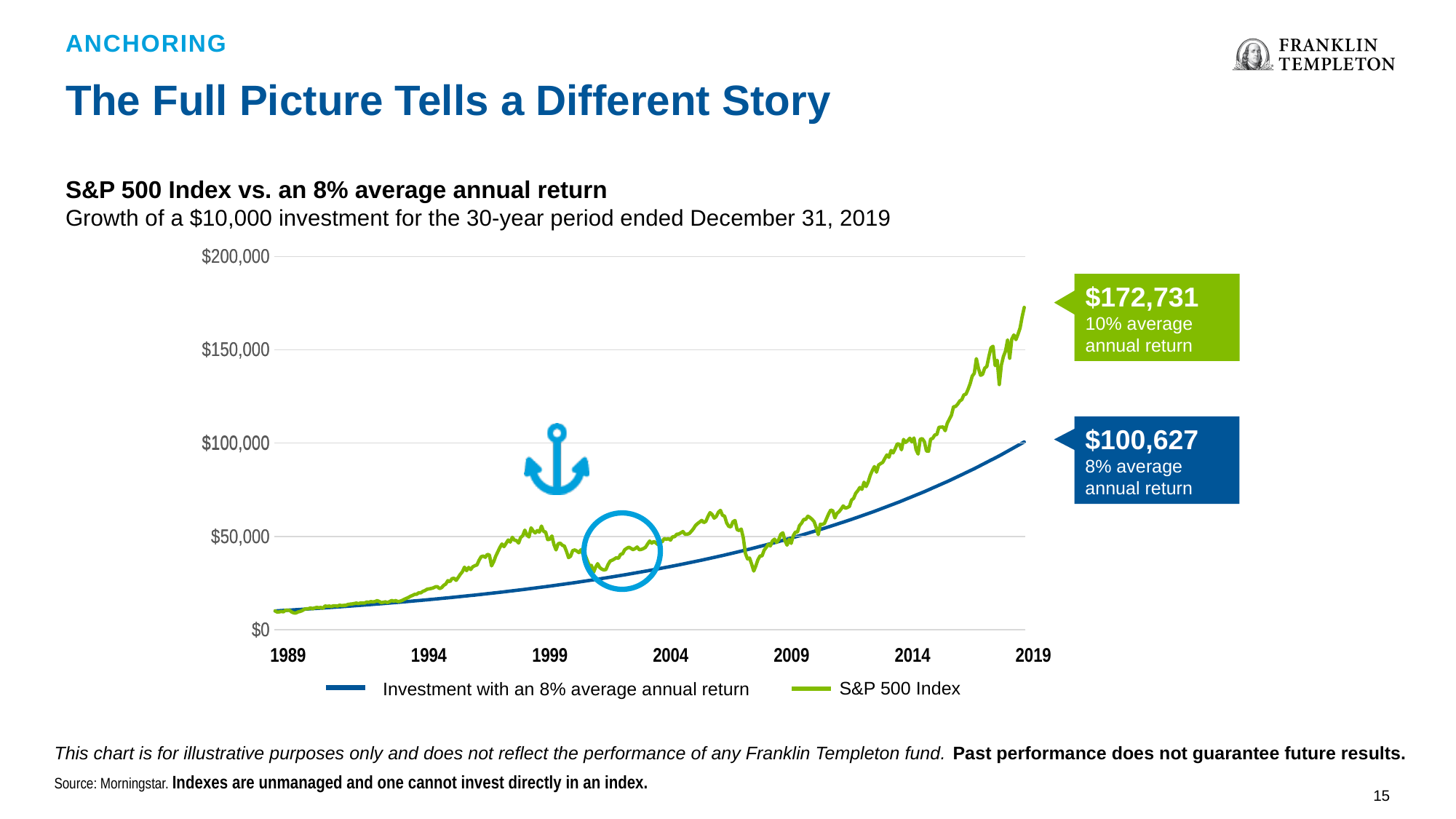
Does the investment with an 8% average annual return line rise or fall from 1989 to 2019? Rise How many series does the legend list? 2 Is the value of the 8% average annual return line in 2014 greater or less than $100,000? less What is the ending value of the S&P 500 Index line at the end of 2019? $172,731 What colour is the S&P 500 Index line? Green Is the value of the S&P 500 Index line in 2009 greater or less than $100,000? less What is the title of the chart? S&P 500 Index vs. an 8% average annual return What average annual return does the slide attribute to the S&P 500 Index over the period? 10% What is the difference between the ending value of the S&P 500 Index and the ending value of the 8% average annual return investment? $72,104 What kind of chart is shown on the slide? Line chart What is the ending value of the investment with an 8% average annual return at the end of 2019? $100,627 Which series ends higher in 2019, the S&P 500 Index or the investment with an 8% average annual return? S&P 500 Index